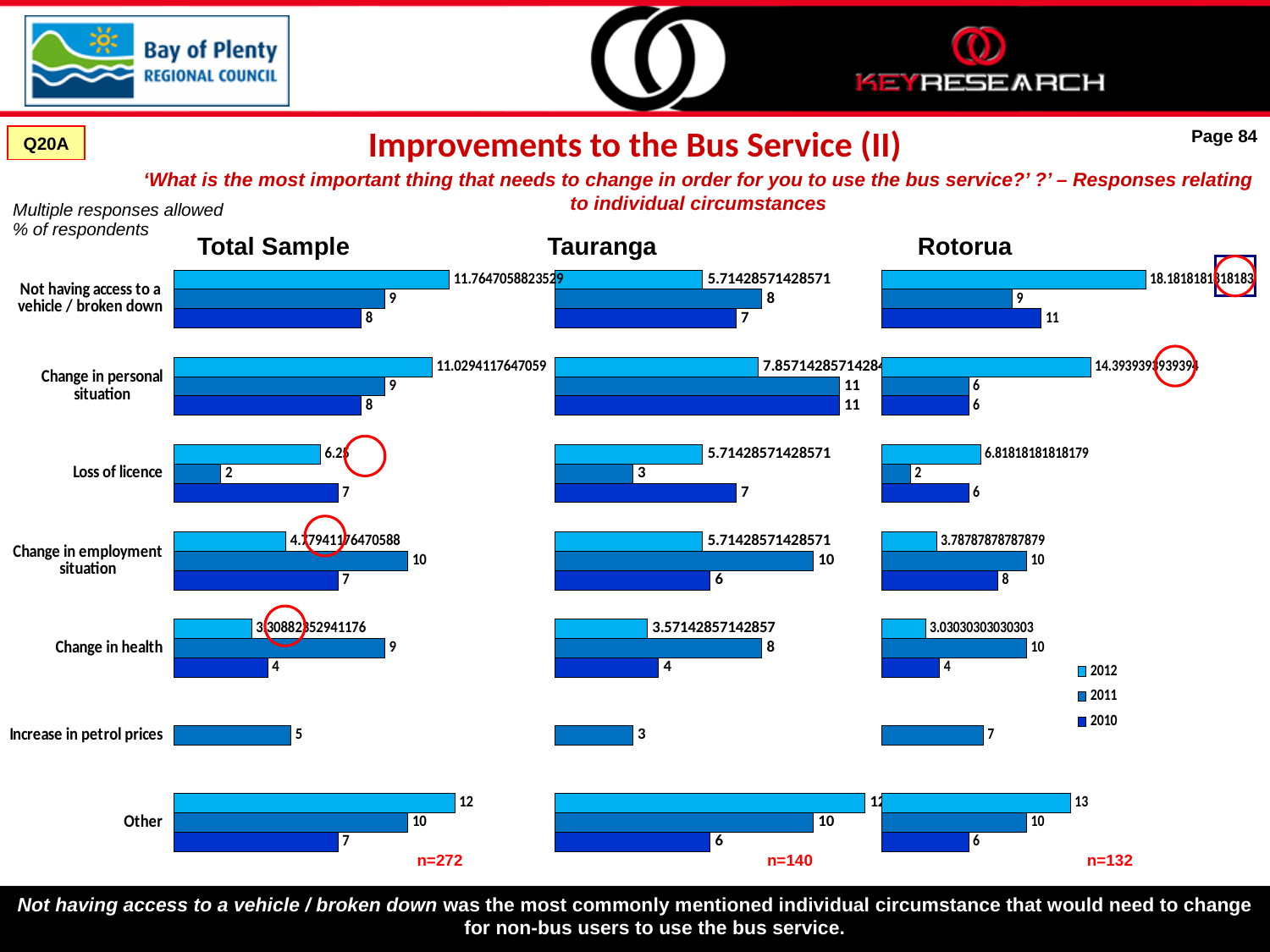
In the Rotorua chart, which is larger for 'Change in employment situation': the 2011 value or the 2010 value? 2011 In the Tauranga chart, what is the 2010 value for 'Change in personal situation'? 11 In the Total Sample chart, what is the difference between the 2011 and 2010 values for 'Other'? 3 How many series does the legend list for these charts? 3 In the Rotorua chart, what is the 2012 value for 'Loss of licence'? 6.81818181818179 What is the sample size (n) shown under the Tauranga chart? n=140 How many categories are shown on the y axis of the Total Sample chart? 7 In the Rotorua chart, what is the 2010 value for 'Not having access to a vehicle / broken down'? 11 In the Tauranga chart, what is the value for 'Increase in petrol prices'? 3 In the Total Sample chart, what is the 2011 value for 'Change in employment situation'? 10 In the Tauranga chart, what is the 2012 value for 'Change in health'? 3.57142857142857 What kind of chart is the Rotorua chart? Bar chart